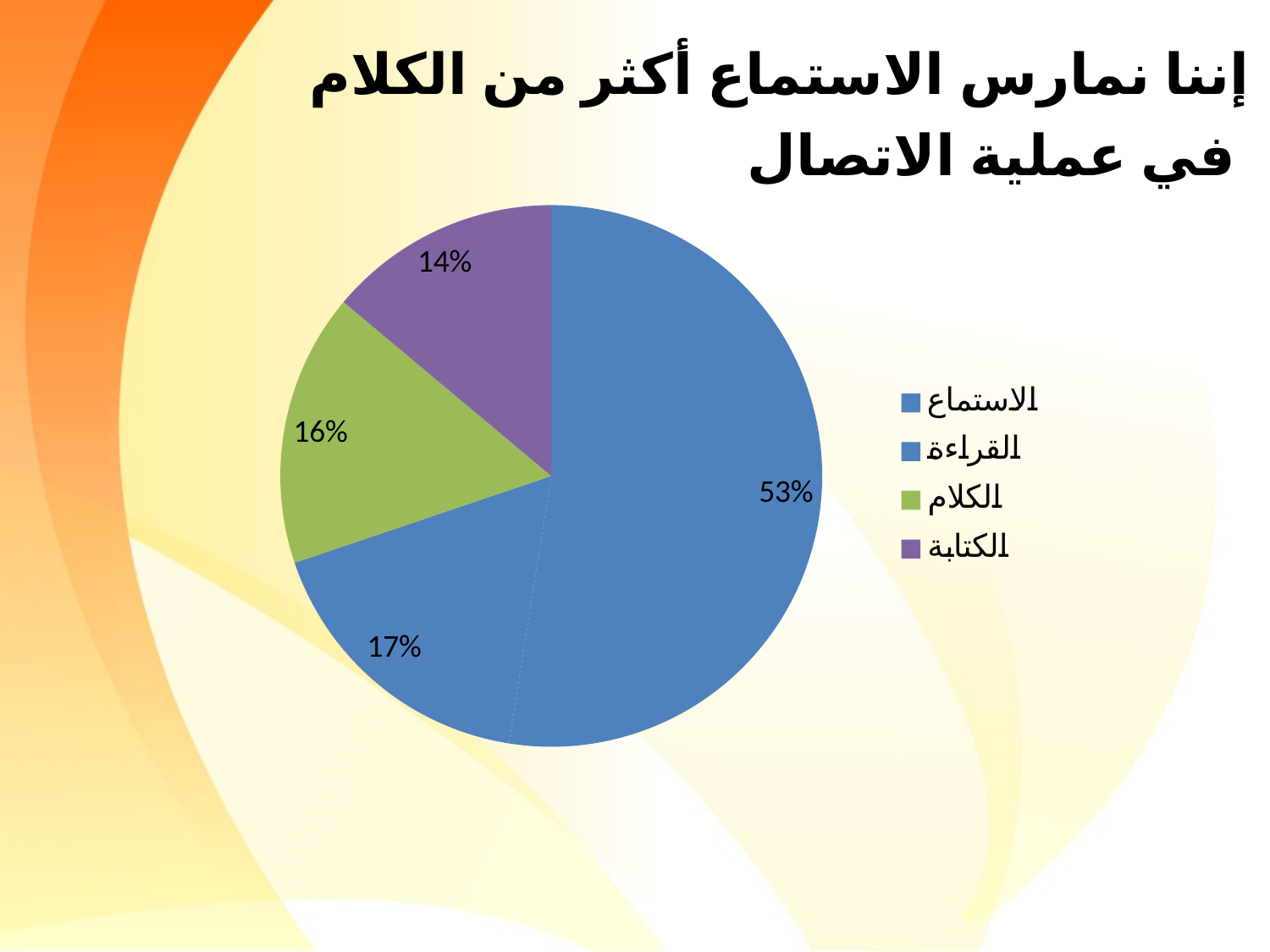
Which category has the smallest slice of the pie? الكتابة What percentage does the slice for الاستماع show? 53% Which category has the largest slice of the pie? الاستماع What kind of chart is shown on the slide? pie chart How many entries does the legend list? 4 Which is larger, the slice for القراءة or the slice for الكتابة? القراءة What percentage does the slice for الكتابة show? 14% What is the difference in percentage points between الاستماع and الكلام? 37 What colour is the slice for الكلام? green How many slices does the pie chart have? 4 What percentage does the slice for الكلام show? 16% What percentage does the slice for القراءة show? 17%